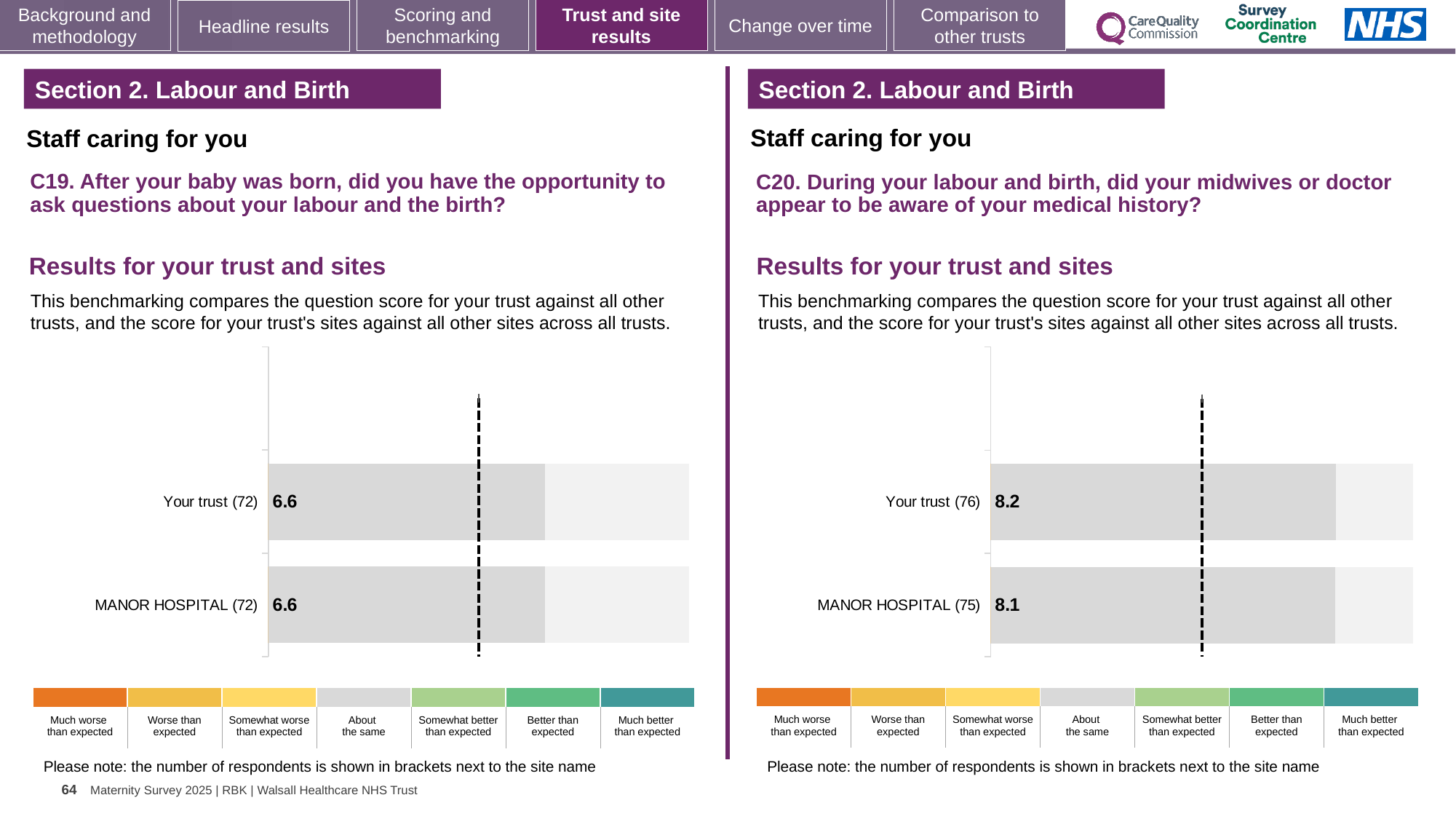
How many bars are plotted on the left chart (C19)? 2 On the left chart (C19), how many respondents are shown in brackets for MANOR HOSPITAL? 72 On the right chart (C20), what is the score for MANOR HOSPITAL? 8.1 On the left chart (C19), what is the difference between the Your trust score and the MANOR HOSPITAL score? 0 How many bars are plotted on the right chart (C20)? 2 What type of chart is used on the right (C20)? Bar chart How many categories does the colour legend below the left chart (C19) list? 7 On the left chart (C19), what is the score for Your trust? 6.6 On the right chart (C20), what is the difference between the Your trust score and the MANOR HOSPITAL score? 0.1 On the right chart (C20), how many respondents are shown in brackets for Your trust? 76 On the left chart (C19), what is the score for MANOR HOSPITAL? 6.6 On the right chart (C20), what is the score for Your trust? 8.2